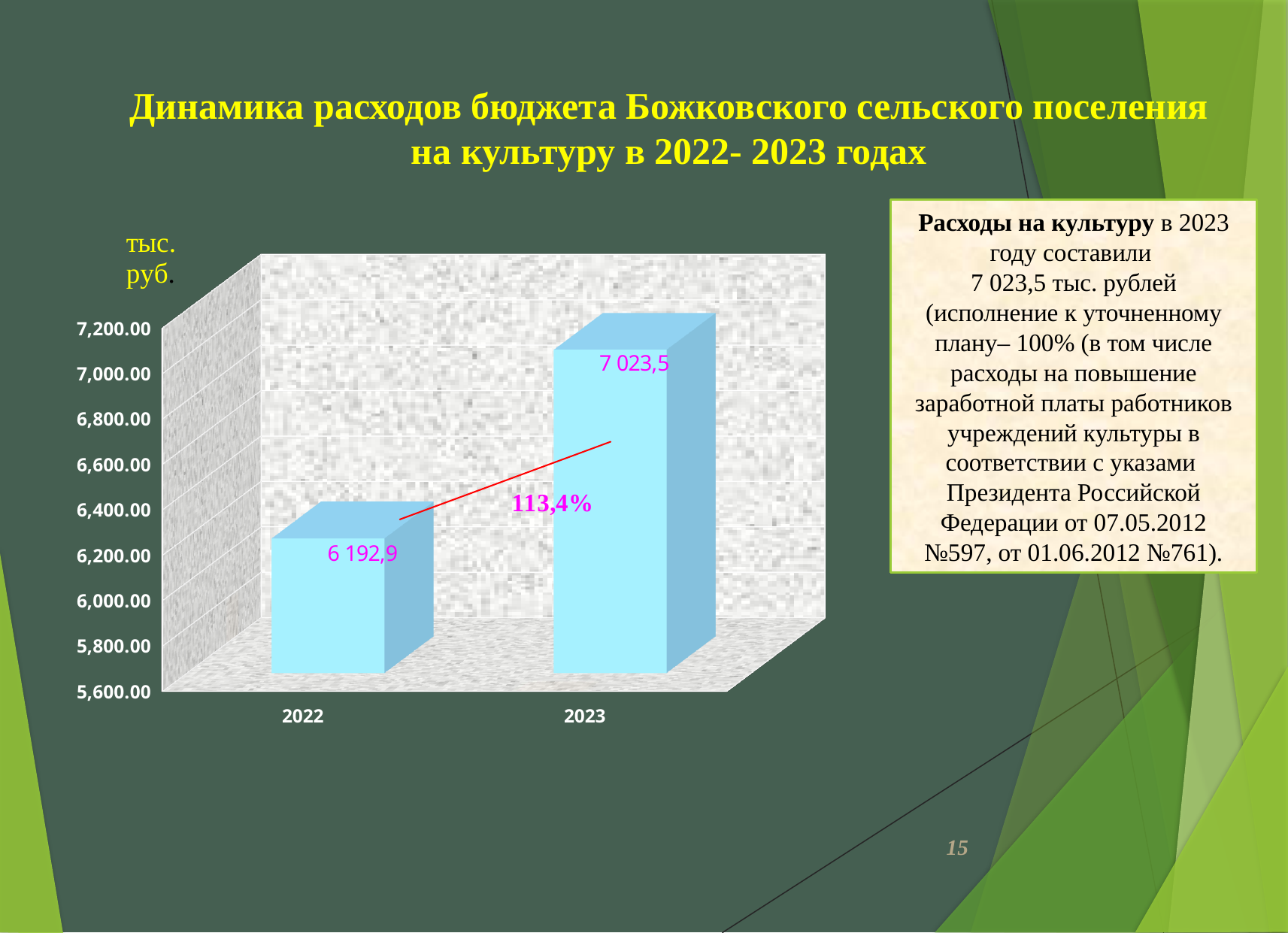
What unit is indicated above the chart's vertical axis? тыс. руб. Which year has the lower value on the chart? 2022 Which year has the higher value on the chart? 2023 What is the value for 2022 on the chart? 6 192,9 What is the value for 2023 on the chart? 7 023,5 Is the value for 2023 greater or less than 7,000.00? greater What kind of chart is shown on the slide? bar chart Do the values rise or fall from 2022 to 2023? rise How many years are shown on the chart's x axis? 2 What percentage is written next to the red line between the two bars? 113,4% Is the value for 2022 greater or less than 6,400.00? less What is the difference between the 2023 and 2022 values on the chart? 830,6